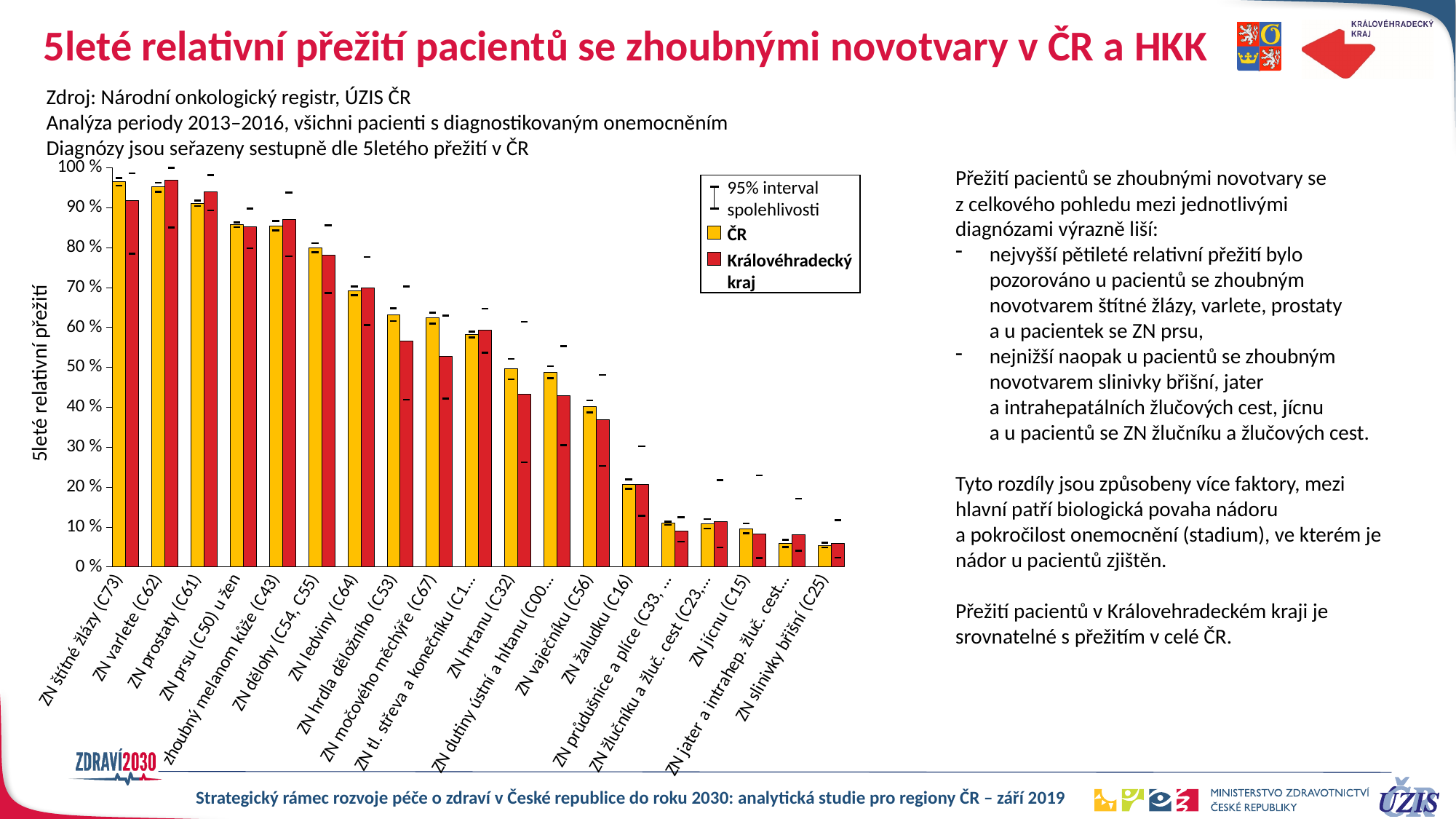
For ZN močového měchýře (C67), which is larger: the ČR value or the Královéhradecký kraj value? ČR What kind of chart is shown on the slide? bar chart Which diagnosis has the highest 5-year relative survival for ČR? ZN štítné žlázy (C73) How many diagnosis categories are shown on the x axis of the chart? 19 Which diagnosis has the lowest 5-year relative survival for ČR? ZN slinivky břišní (C25) Do the ČR values rise or fall from left to right along the x axis? fall For ZN štítné žlázy (C73), which is larger: the ČR value or the Královéhradecký kraj value? ČR Which diagnosis has the highest 5-year relative survival for Královéhradecký kraj? ZN varlete (C62) How many bar series does the legend list? 2 Is the ČR value for ZN prsu (C50) u žen greater or less than 80 %? greater Is the ČR value for ZN vaječníku (C56) greater or less than 50 %? less Is the Královéhradecký kraj value for ZN hrdla děložního (C53) greater or less than 50 %? greater